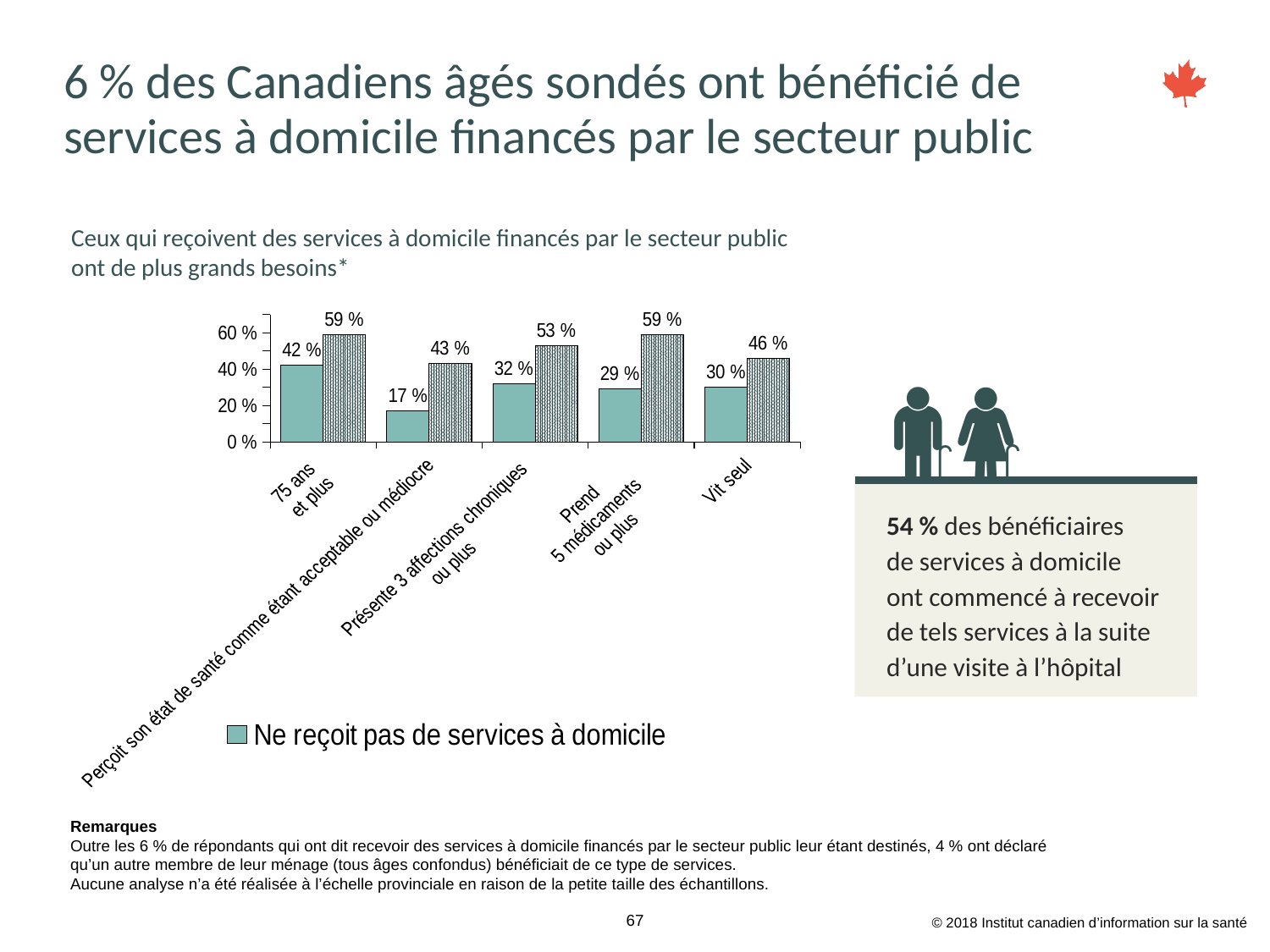
Which category has the highest value for 'Ne reçoit pas de services à domicile'? 75 ans et plus For '75 ans et plus', what is the difference between the hatched bar and the 'Ne reçoit pas de services à domicile' bar? 17 % What is the value of the 'Ne reçoit pas de services à domicile' bar for '75 ans et plus'? 42 % What value is shown on the hatched (patterned) bar for 'Prend 5 médicaments ou plus'? 59 % For 'Perçoit son état de santé comme étant acceptable ou médiocre', what is the difference between the hatched bar (43 %) and the 'Ne reçoit pas de services à domicile' bar (17 %)? 26 % Which has the larger hatched-bar value: 'Vit seul' or 'Présente 3 affections chroniques ou plus'? Présente 3 affections chroniques ou plus What is the value of the 'Ne reçoit pas de services à domicile' bar for 'Vit seul'? 30 % What is the legend entry shown below the chart? Ne reçoit pas de services à domicile Which category has the lowest value for 'Ne reçoit pas de services à domicile'? Perçoit son état de santé comme étant acceptable ou médiocre How many categories are shown on the x axis of the chart? 5 What type of chart is shown on the slide? Bar chart What is the value of the 'Ne reçoit pas de services à domicile' bar for 'Présente 3 affections chroniques ou plus'? 32 %